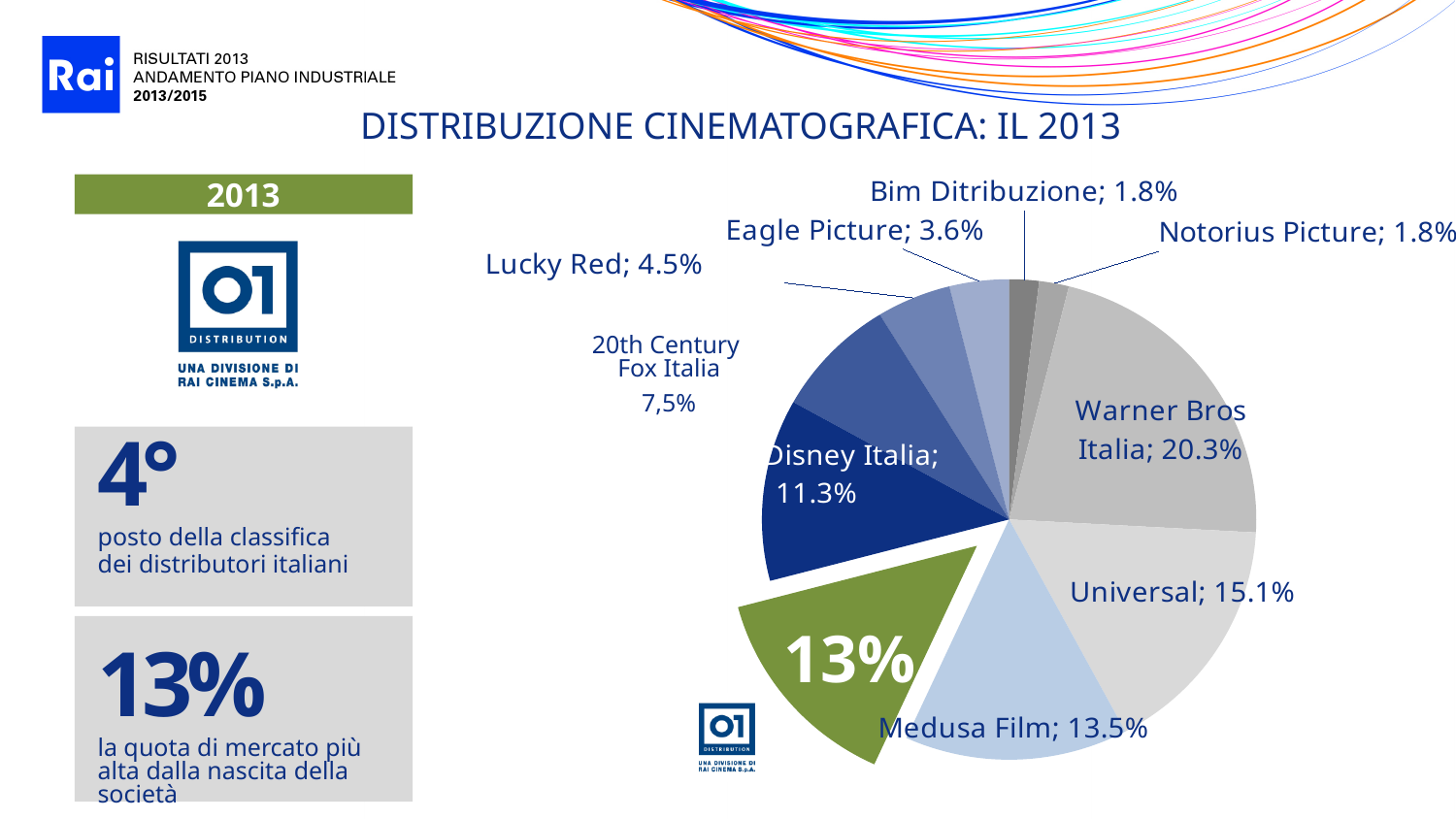
How many slices does the pie chart have? 10 What is the title of the slide containing the pie chart? DISTRIBUZIONE CINEMATOGRAFICA: IL 2013 What is the difference between the shares of Warner Bros Italia and Universal? 5.2% What share of the pie does Warner Bros Italia hold? 20.3% What is the value shown for Universal? 15.1% What kind of chart is shown on the slide? pie chart Which is larger, the share of Medusa Film or the share of Disney Italia? Medusa Film What is the value shown for Eagle Picture? 3.6% Which distributor has the largest slice of the pie? Warner Bros Italia What is the value shown for Disney Italia? 11.3% What is the value shown for Medusa Film? 13.5% What is the value shown for Lucky Red? 4.5%